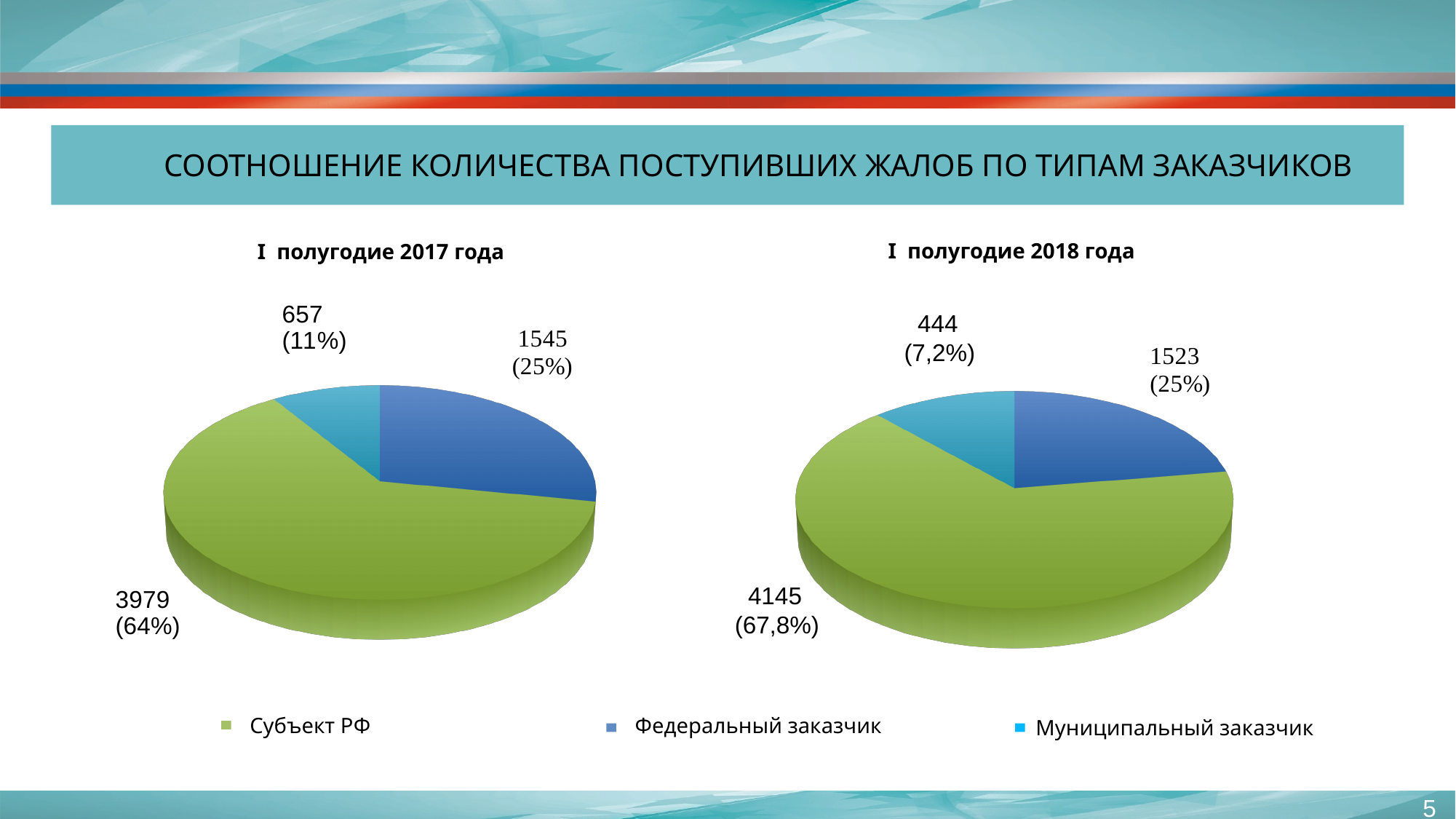
How many slices does the chart titled "I полугодие 2017 года" have? 3 In the chart titled "I полугодие 2018 года", what share of the pie does Субъект РФ represent? 67,8% Which is larger: the value for Субъект РФ in the "I полугодие 2017 года" chart or in the "I полугодие 2018 года" chart? I полугодие 2018 года In the chart titled "I полугодие 2017 года", what value is shown for Субъект РФ? 3979 (64%) In the chart titled "I полугодие 2018 года", what value is shown for Муниципальный заказчик? 444 (7,2%) In the chart titled "I полугодие 2017 года", what is the difference between the values for Федеральный заказчик and Муниципальный заказчик? 888 What type of chart is used for "I полугодие 2018 года"? Pie chart Which colour represents Федеральный заказчик in the legend? Blue In the chart titled "I полугодие 2017 года", what share of the pie does Муниципальный заказчик represent? 11% In the chart titled "I полугодие 2018 года", what value is shown for Федеральный заказчик? 1523 (25%) In the chart titled "I полугодие 2017 года", which category has the largest slice? Субъект РФ In the chart titled "I полугодие 2018 года", which category has the smallest slice? Муниципальный заказчик